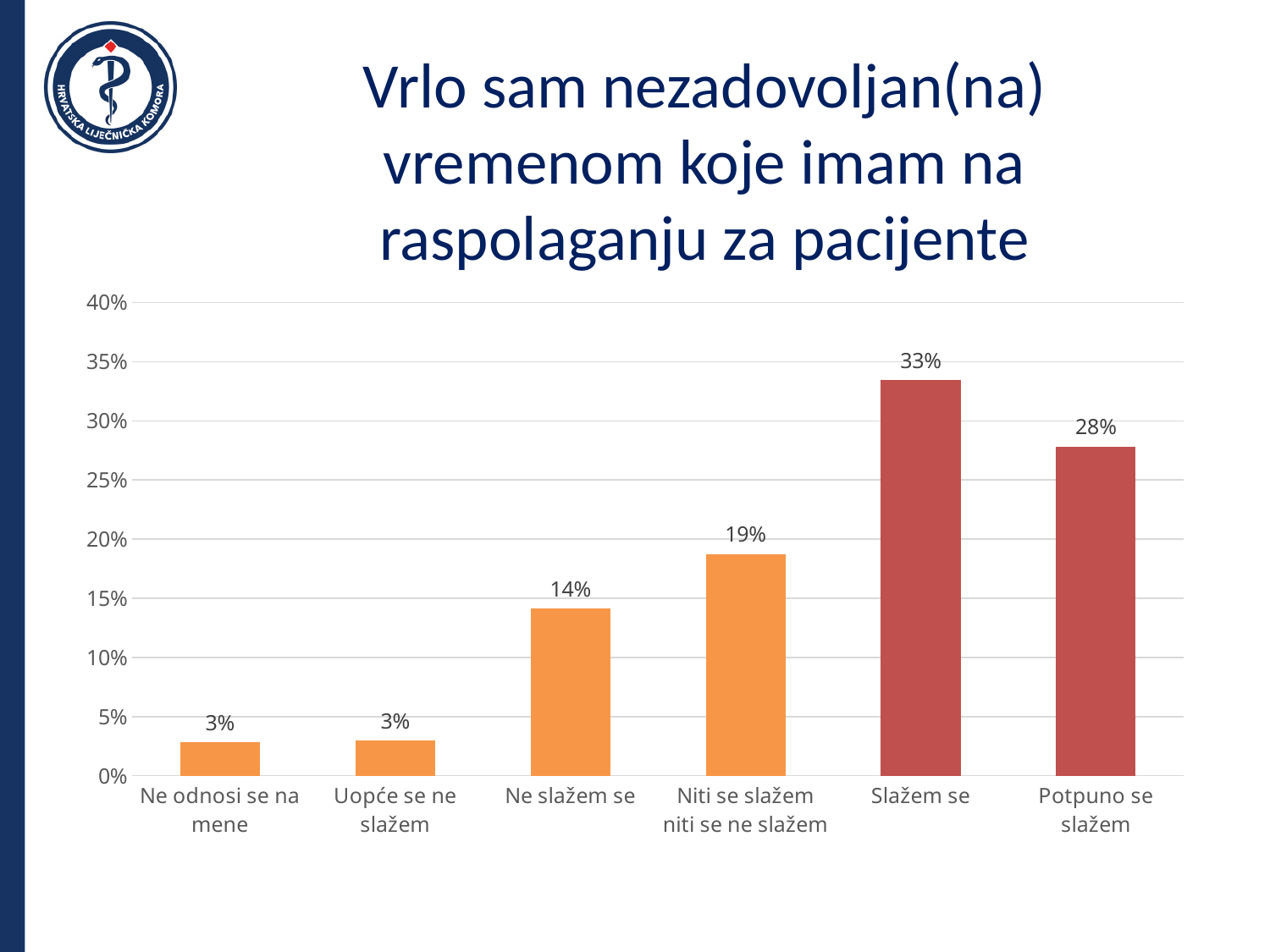
What kind of chart is shown on the slide? bar chart What is the value for "Niti se slažem niti se ne slažem"? 19% Which is larger, the value for "Ne slažem se" or the value for "Niti se slažem niti se ne slažem"? Niti se slažem niti se ne slažem What is the combined value of "Slažem se" and "Potpuno se slažem"? 61% What is the highest value shown on the y axis? 40% Which category has the highest value? Slažem se What is the value for "Ne slažem se"? 14% What is the value for "Slažem se"? 33% Is the value for "Potpuno se slažem" greater or less than 25%? greater How many categories are shown on the x axis? 6 What is the value for "Uopće se ne slažem"? 3% What is the difference between the values for "Slažem se" and "Potpuno se slažem"? 5%